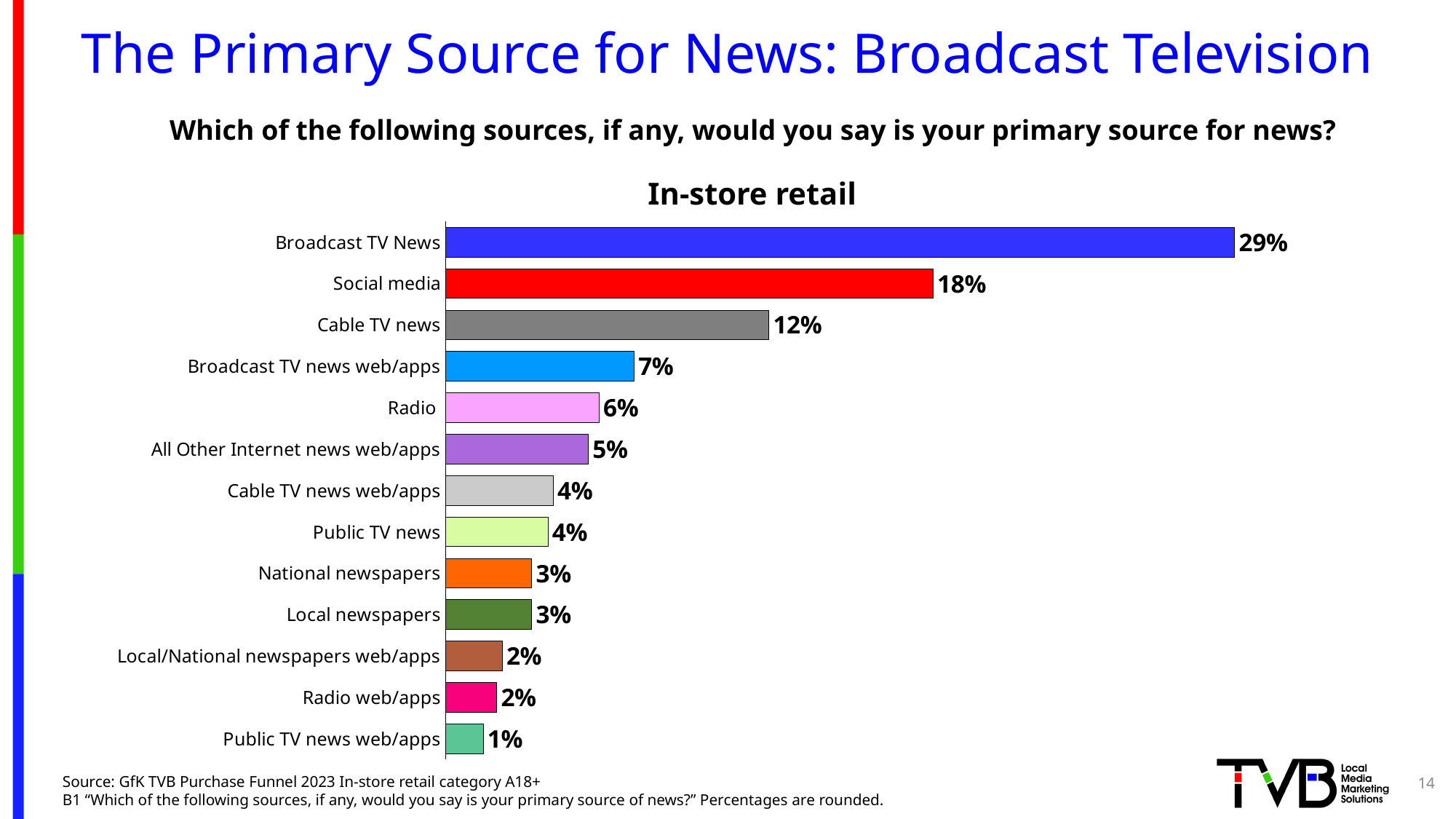
What kind of chart is shown on the slide? Bar chart What is the difference between the values for Broadcast TV News and Social media? 11 percentage points What colour is the bar for Social media? Red Which is larger, the value for Broadcast TV news web/apps or the value for Radio? Broadcast TV news web/apps How many sources (categories) are shown in the chart? 13 What is the difference between the values for Cable TV news and Radio? 6 percentage points What is the value shown for Cable TV news web/apps? 4% What is the title of the chart? In-store retail Which source has the highest value in the chart? Broadcast TV News What percentage of respondents named Broadcast TV News as their primary source for news? 29% What is the value shown for Social media? 18% Which source has the lowest value in the chart? Public TV news web/apps